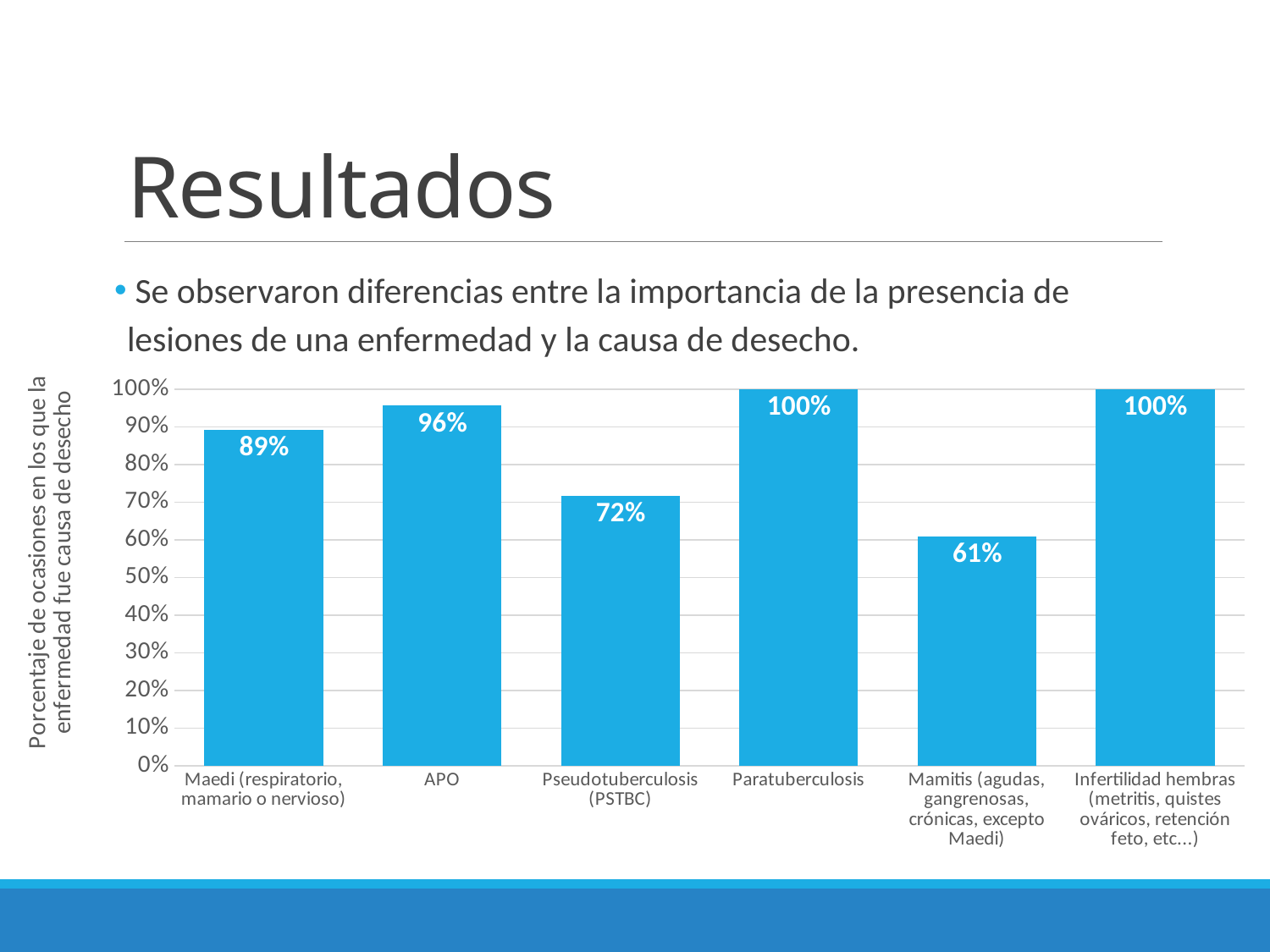
Which category has the lowest value? Mamitis (agudas, gangrenosas, crónicas, excepto Maedi) How many categories are shown on the x axis? 6 What is the value for Paratuberculosis? 100% Which is larger, the value for APO or the value for Maedi (respiratorio, mamario o nervioso)? APO How many categories have a value of 100%? 2 Is the value for Mamitis (agudas, gangrenosas, crónicas, excepto Maedi) greater or less than 70%? less What is the value for APO? 96% What is the value for Maedi (respiratorio, mamario o nervioso)? 89% What is the difference between the values for APO and Mamitis (agudas, gangrenosas, crónicas, excepto Maedi)? 35% What is the value for Pseudotuberculosis (PSTBC)? 72% What kind of chart is shown on the slide? bar chart What is the difference between the values for Maedi (respiratorio, mamario o nervioso) and Pseudotuberculosis (PSTBC)? 17%